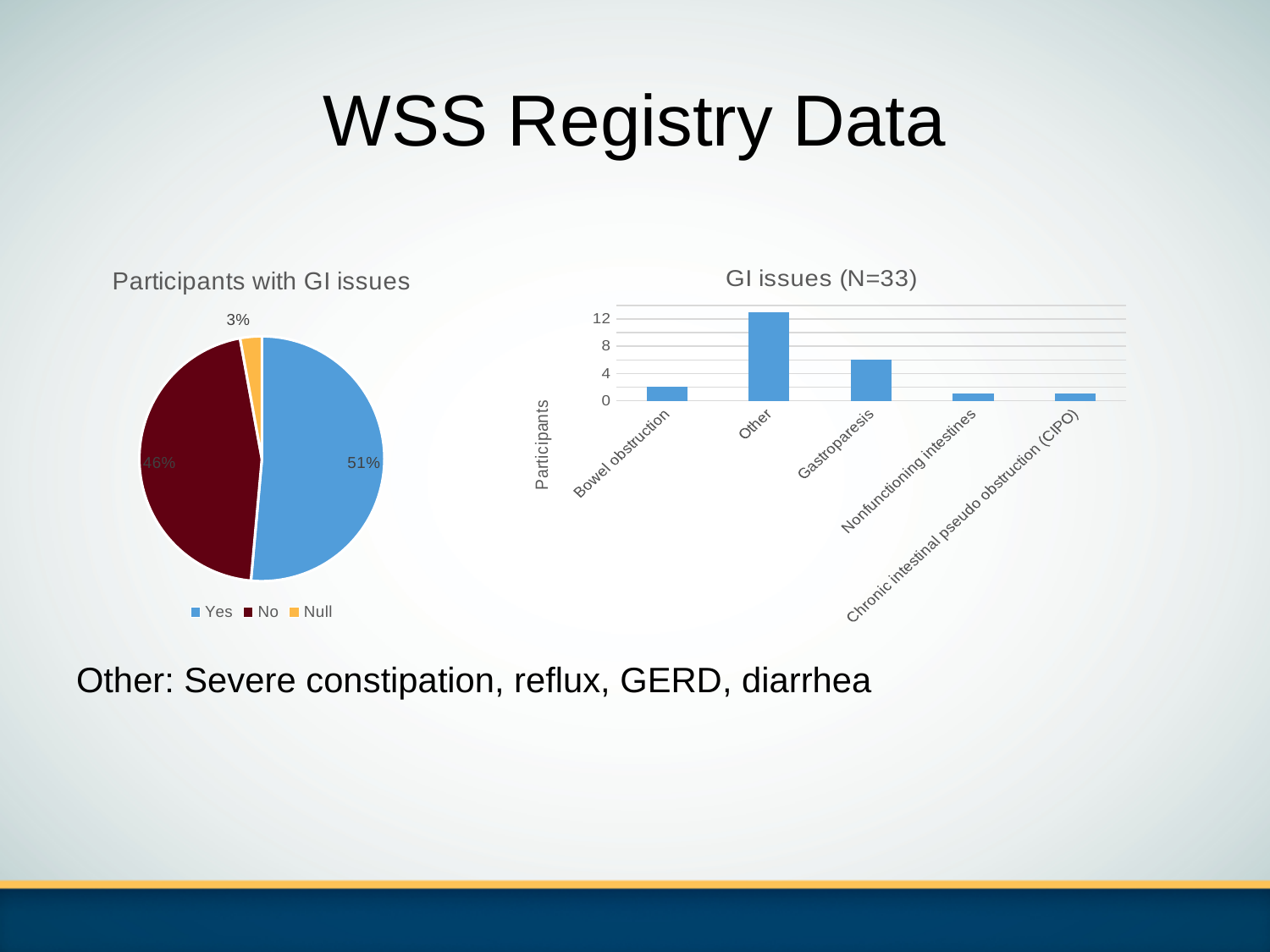
In the pie chart 'Participants with GI issues', what share is labelled Null? 3% In the pie chart 'Participants with GI issues', what share of participants answered Yes? 51% In the bar chart 'GI issues (N=33)', is the value for Gastroparesis greater or less than 4? greater In the bar chart 'GI issues (N=33)', how many categories are shown on the x axis? 5 How many entries does the legend of the pie chart 'Participants with GI issues' list? 3 In the pie chart 'Participants with GI issues', what is the difference in percentage points between Yes and No? 5 What kind of chart is 'GI issues (N=33)'? Bar chart In the bar chart 'GI issues (N=33)', is the value for Other greater or less than 12? greater In the pie chart 'Participants with GI issues', which slice is the smallest? Null In the pie chart 'Participants with GI issues', what share of participants answered No? 46% In the bar chart 'GI issues (N=33)', which category has the highest number of participants? Other In the pie chart 'Participants with GI issues', which slice is the largest? Yes